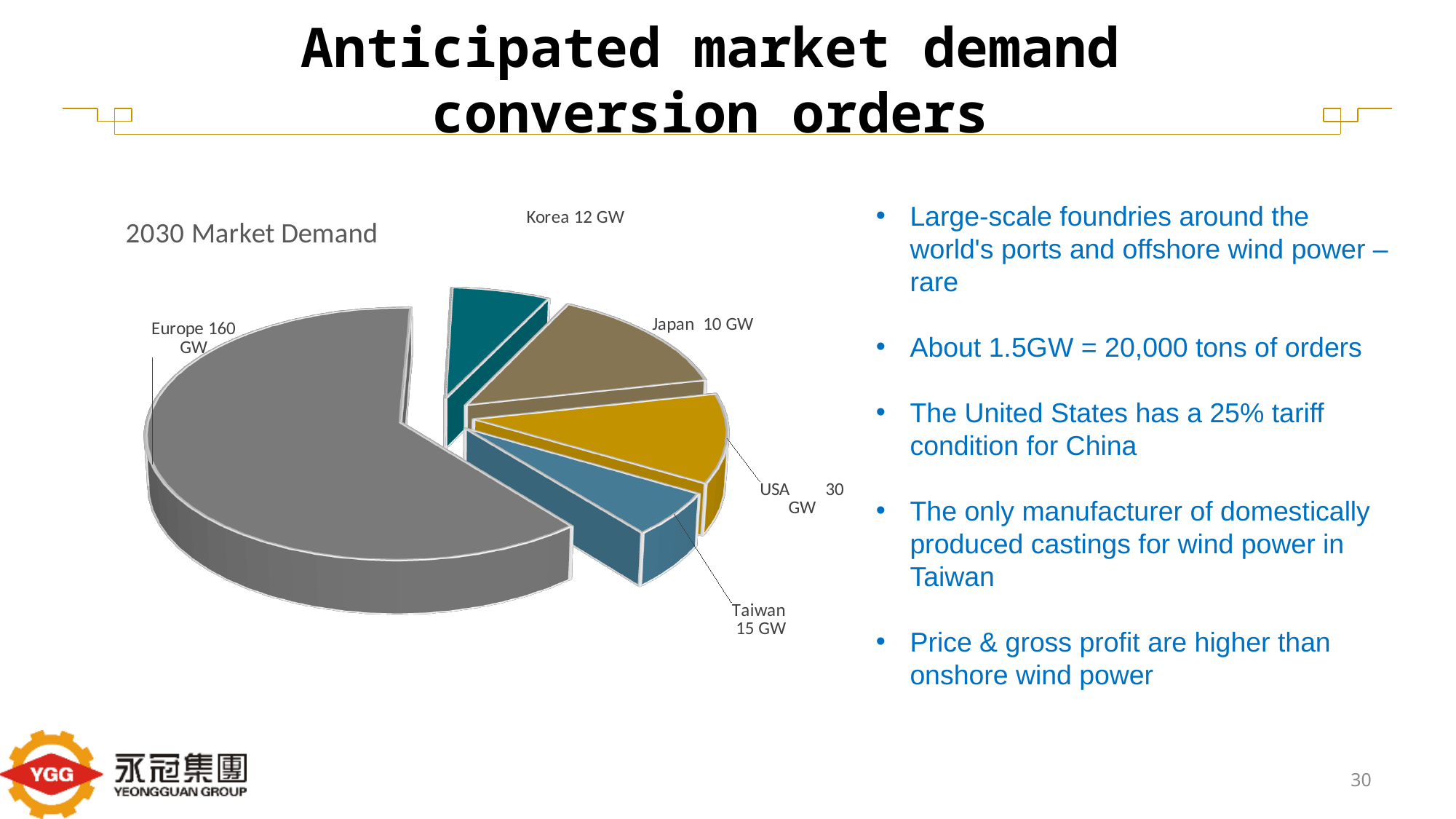
What is the value for Japan in the 2030 Market Demand pie chart? 10 GW What is the value for Korea in the 2030 Market Demand pie chart? 12 GW What is the value for USA in the 2030 Market Demand pie chart? 30 GW What is the value for Europe in the 2030 Market Demand pie chart? 160 GW What kind of chart is used to show the 2030 Market Demand? Pie chart Which region has the largest slice in the 2030 Market Demand pie chart? Europe What is the difference between the USA and Taiwan values in the 2030 Market Demand pie chart? 15 GW How many regions are shown in the 2030 Market Demand pie chart? 5 What is the value for Taiwan in the 2030 Market Demand pie chart? 15 GW What is the difference between the Europe and USA values in the 2030 Market Demand pie chart? 130 GW